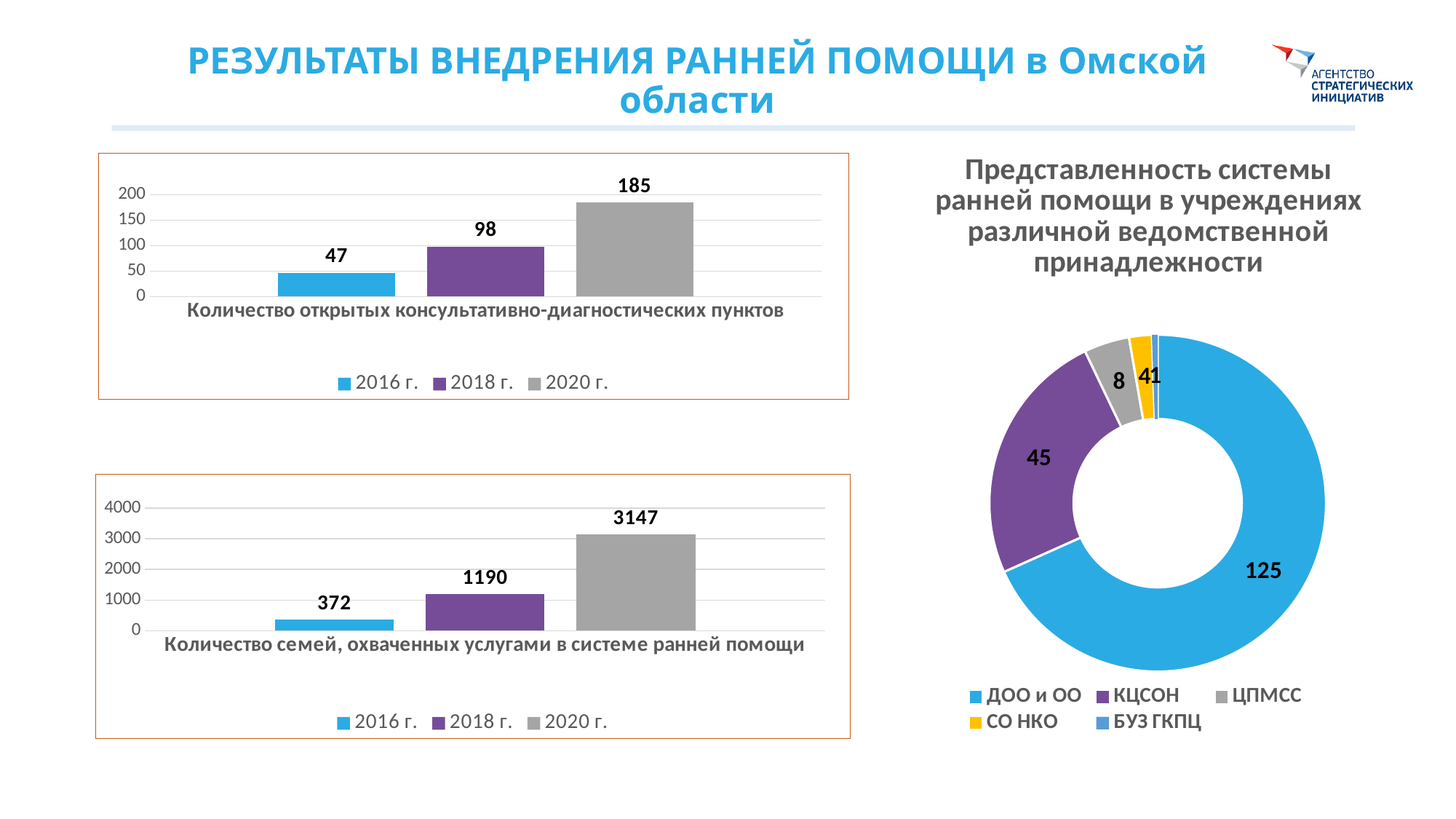
In the bottom-left bar chart (Количество семей, охваченных услугами в системе ранней помощи), do the values rise or fall from 2016 г. to 2020 г.? rise In the top-left bar chart (Количество открытых консультативно-диагностических пунктов), which year has the lowest value? 2016 г. How many series does the legend of the top-left bar chart list? 3 In the bottom-left bar chart (Количество семей, охваченных услугами в системе ранней помощи), what is the value for 2018 г.? 1190 How many categories does the legend of the donut chart on the right list? 5 In the top-left bar chart (Количество открытых консультативно-диагностических пунктов), what is the value for 2016 г.? 47 In the top-left bar chart (Количество открытых консультативно-диагностических пунктов), what is the value for 2020 г.? 185 In the bottom-left bar chart (Количество семей, охваченных услугами в системе ранней помощи), what is the difference between the 2020 г. and 2016 г. values? 2775 In the bottom-left bar chart (Количество семей, охваченных услугами в системе ранней помощи), which year has the highest value? 2020 г. In the top-left bar chart (Количество открытых консультативно-диагностических пунктов), what is the difference between the 2020 г. and 2018 г. values? 87 In the donut chart on the right (Представленность системы ранней помощи...), which category has the largest value? ДОО и ОО In the donut chart on the right (Представленность системы ранней помощи...), what is the value for КЦСОН? 45